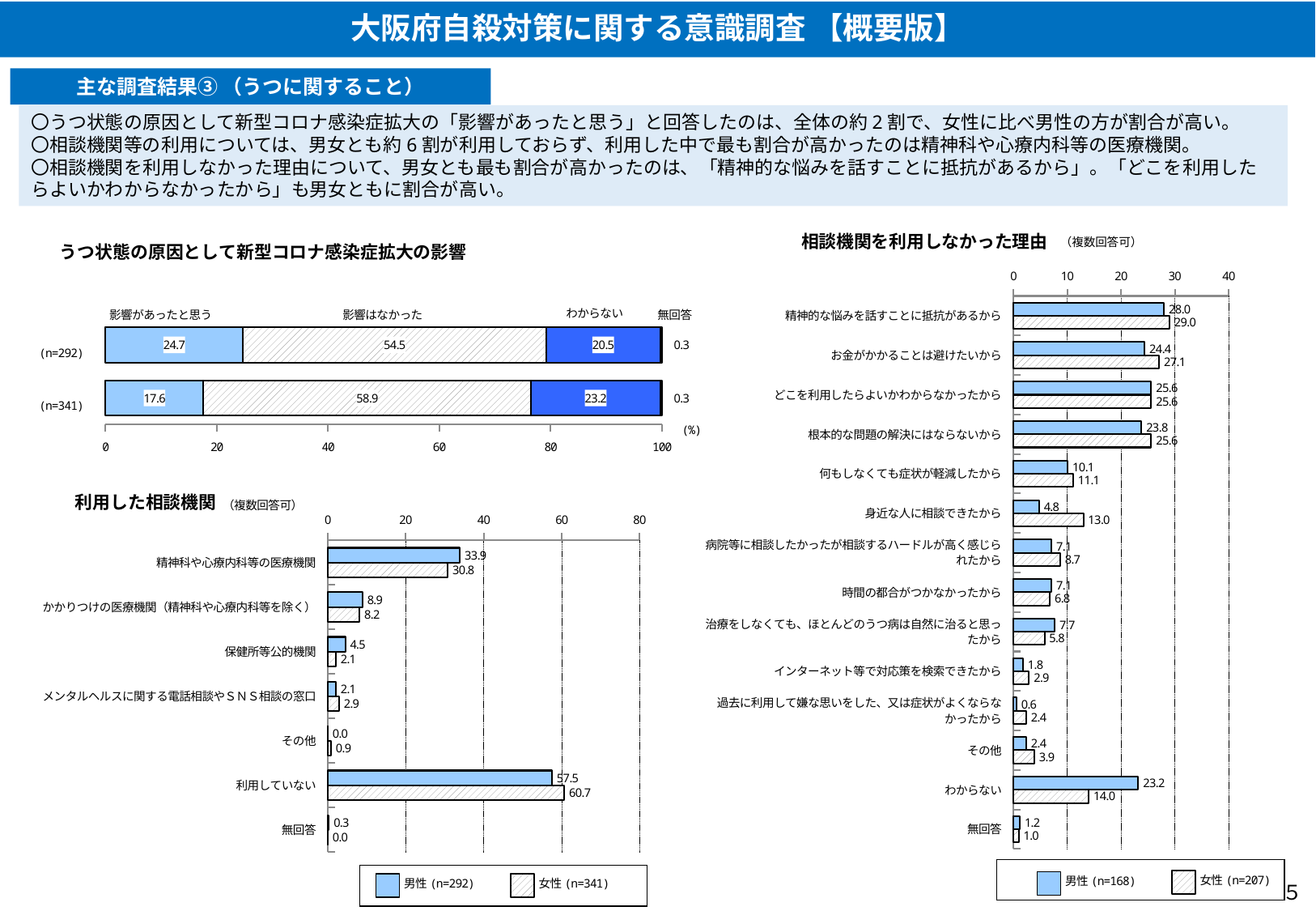
In the chart titled 「うつ状態の原因として新型コロナ感染症拡大の影響」, what is the value of 「影響があったと思う」 for the (n=292) row? 24.7 In the chart titled 「利用した相談機関」, which category has the highest 女性 value? 利用していない In the chart titled 「相談機関を利用しなかった理由」, what are the two legend entries? 男性 (n=168) and 女性 (n=207) In the chart titled 「うつ状態の原因として新型コロナ感染症拡大の影響」, what kind of chart is it? Stacked bar chart In the chart titled 「利用した相談機関」, how many categories are shown? 7 In the chart titled 「利用した相談機関」, what is the 男性 value for 「精神科や心療内科等の医療機関」? 33.9 In the chart titled 「相談機関を利用しなかった理由」, which category has the highest 男性 value? 精神的な悩みを話すことに抵抗があるから In the chart titled 「相談機関を利用しなかった理由」, which is larger for 「わからない」: the 男性 value or the 女性 value? 男性 In the chart titled 「相談機関を利用しなかった理由」, what is the 女性 value for 「身近な人に相談できたから」? 13.0 In the chart titled 「相談機関を利用しなかった理由」, how many series does the legend list? 2 In the chart titled 「うつ状態の原因として新型コロナ感染症拡大の影響」, what is the value of 「影響はなかった」 for the (n=341) row? 58.9 In the chart titled 「利用した相談機関」, what is the difference between the 女性 and 男性 values for 「利用していない」? 3.2